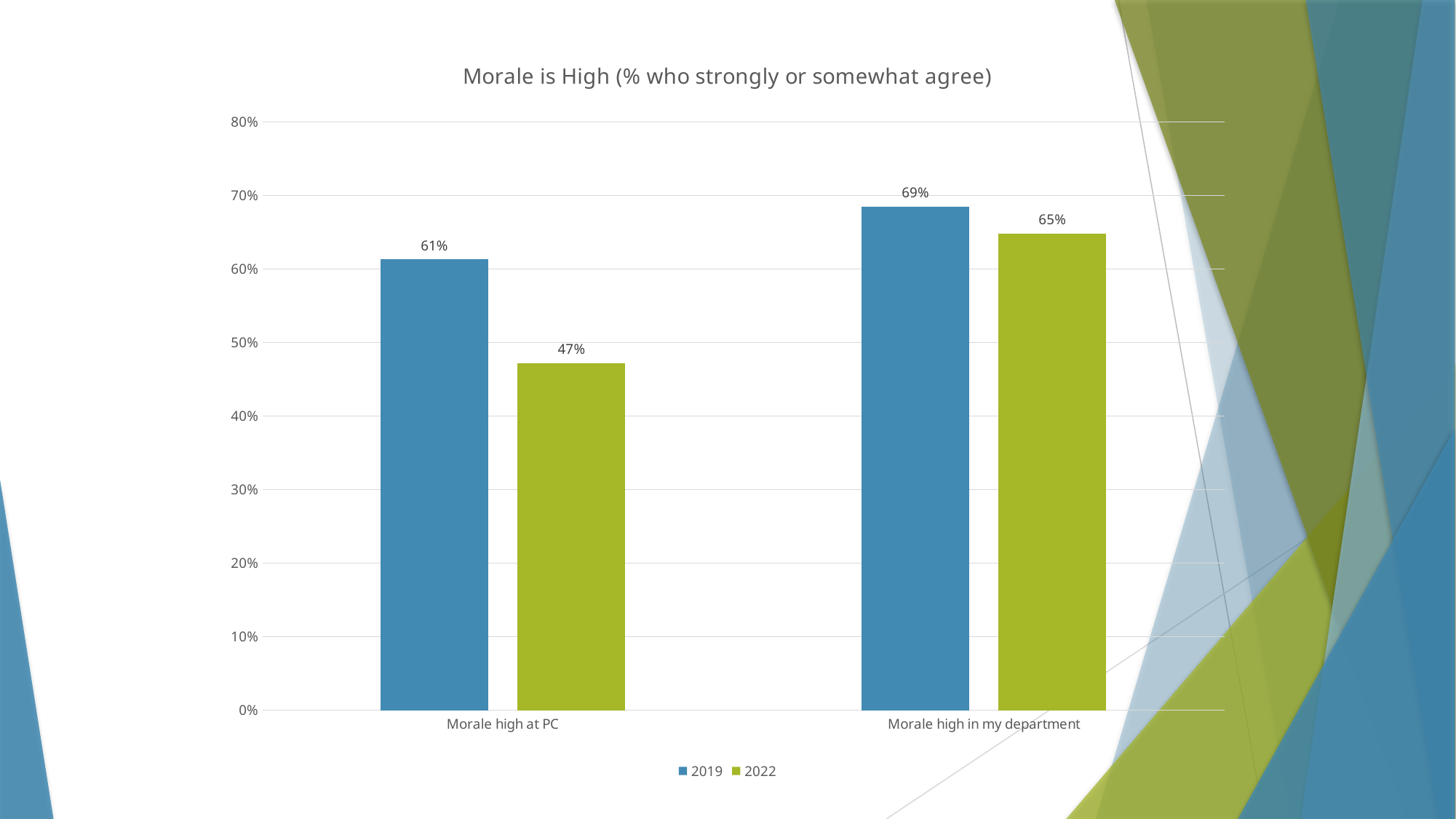
What is the difference between the 2019 and 2022 values for "Morale high at PC"? 14% What is the 2019 value for "Morale high at PC"? 61% What is the 2019 value for "Morale high in my department"? 69% How many series does the legend list? 2 Which category has the lowest 2022 value? Morale high at PC What kind of chart is shown on the slide? Bar chart How many categories are shown on the x axis? 2 For "Morale high in my department", which is larger: the 2019 value or the 2022 value? 2019 What is the 2022 value for "Morale high in my department"? 65% Which category has the highest 2019 value? Morale high in my department What is the difference between the 2019 and 2022 values for "Morale high in my department"? 4% What is the 2022 value for "Morale high at PC"? 47%